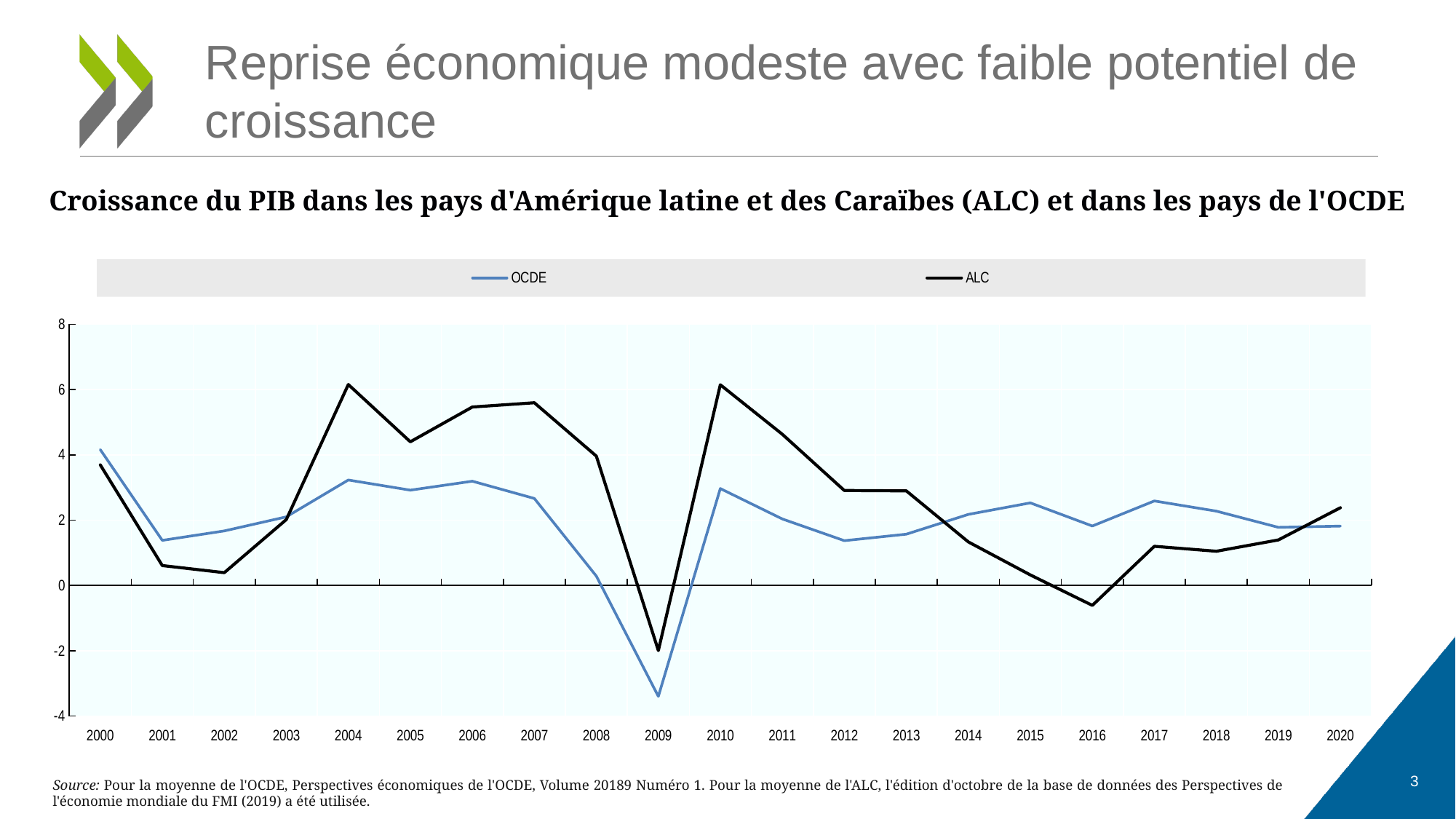
Does the ALC series rise or fall from 2010 to 2016? fall What kind of chart is shown on the slide? line chart In which year does the OCDE series reach its lowest value? 2009 In which year does the OCDE series reach its highest value? 2000 Is the value for ALC in 2009 greater or less than 0? less How many years are plotted along the x axis? 21 In which year does the ALC series reach its lowest value? 2009 How many series does the legend list? 2 Which series has the higher value in 2016, OCDE or ALC? OCDE Is the value for ALC in 2007 greater or less than 4? greater Is the value for OCDE in 2009 greater or less than -2? less Which series has the higher value in 2004, OCDE or ALC? ALC